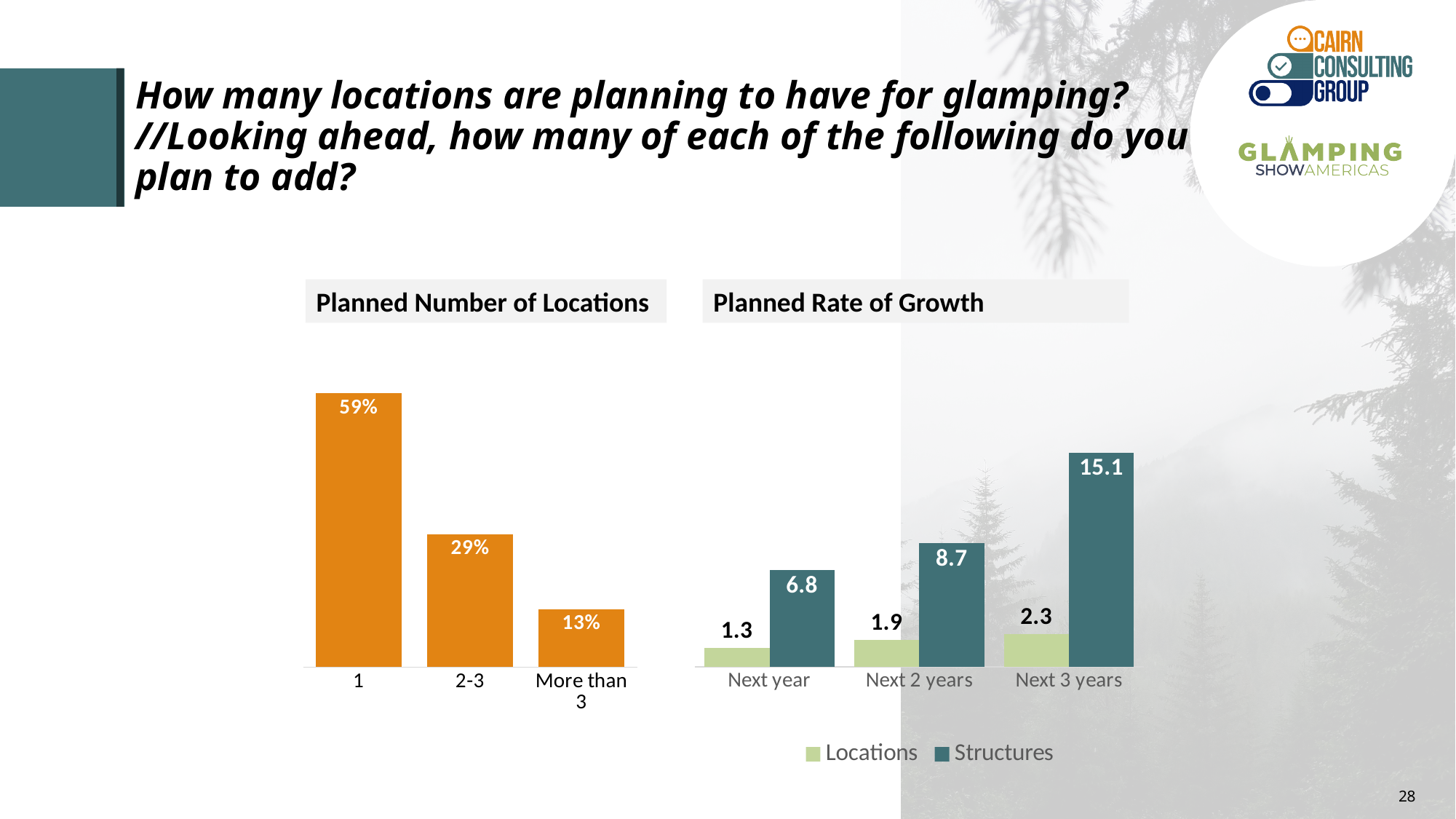
In the 'Planned Rate of Growth' chart, how many series does the legend list? 2 In the 'Planned Number of Locations' chart, what percentage is shown for 'More than 3'? 13% In the 'Planned Number of Locations' chart, what is the difference between the values for '1' and '2-3'? 30% What kind of chart is the 'Planned Rate of Growth' chart? bar chart In the 'Planned Number of Locations' chart, which category has the lowest value? More than 3 In the 'Planned Rate of Growth' chart, what is the difference between the Structures and Locations values for 'Next 3 years'? 12.8 In the 'Planned Rate of Growth' chart, which category has the highest Structures value? Next 3 years In the 'Planned Number of Locations' chart, how many categories are shown on the x axis? 3 In the 'Planned Rate of Growth' chart, what is the value for Locations in 'Next year'? 1.3 In the 'Planned Rate of Growth' chart, what is the value for Structures in 'Next 2 years'? 8.7 In the 'Planned Rate of Growth' chart, do the Locations values rise or fall from 'Next year' to 'Next 3 years'? rise In the 'Planned Number of Locations' chart, what percentage is shown for the category '1'? 59%